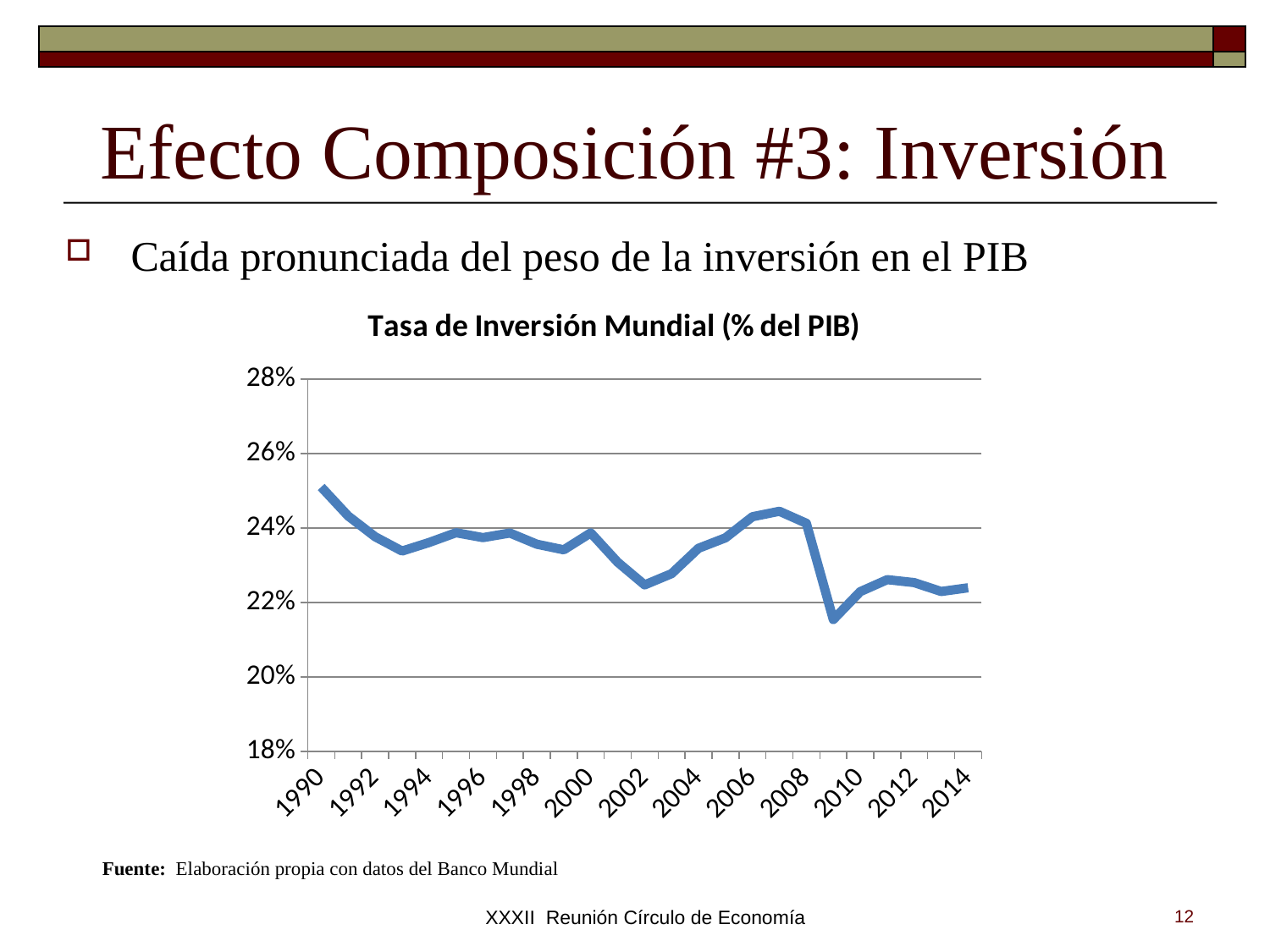
What kind of chart is shown on the slide? line chart What is the title of the chart? Tasa de Inversión Mundial (% del PIB) Which is larger, the value for 2006 or the value for 2002? 2006 Which year has the highest investment rate in the chart? 1990 Is the value for 1990 greater or less than 24%? greater Overall, does the investment rate rise or fall from 1990 to 2014? fall Which is larger, the value for 1990 or the value for 2014? 1990 Is the value for 2002 greater or less than 22%? greater How many year labels are shown on the x axis? 13 Is the value for 2002 greater or less than 24%? less